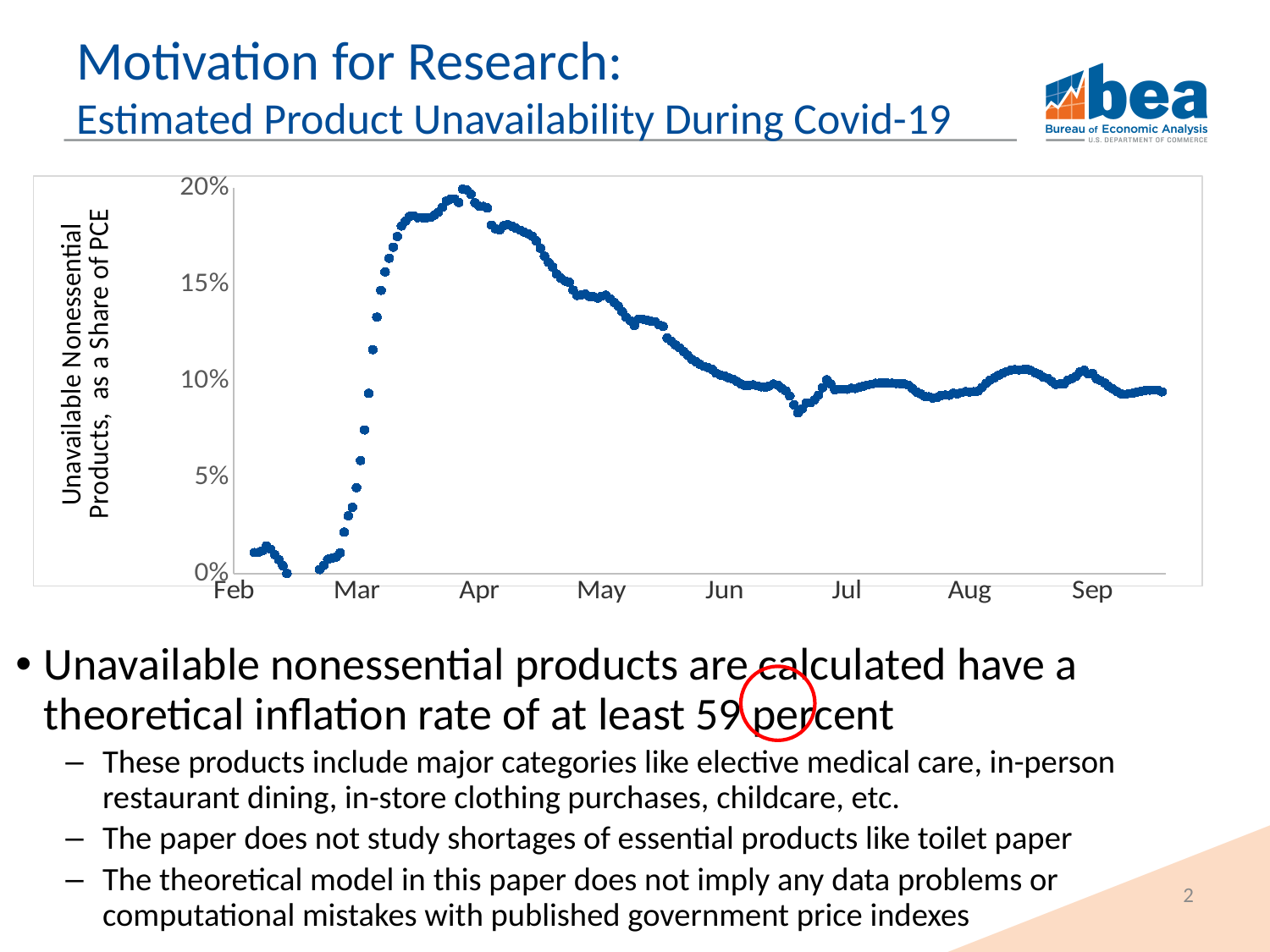
Near which month label on the x axis does the series reach its highest value? Apr How many month labels are shown on the x axis? 8 Which is larger, the value at the Apr tick or the value at the Sep tick? Apr Do the values rise or fall between the Apr tick and the Jun tick? fall What kind of chart is shown on the slide? scatter chart Do the values rise or fall between the Mar tick and the Apr tick? rise Is the value at the May tick greater or less than 10%? greater What is the label on the y axis? Unavailable Nonessential Products, as a Share of PCE Is the value at the Jun tick greater or less than 5%? greater Is the value at the Mar tick greater or less than 5%? less